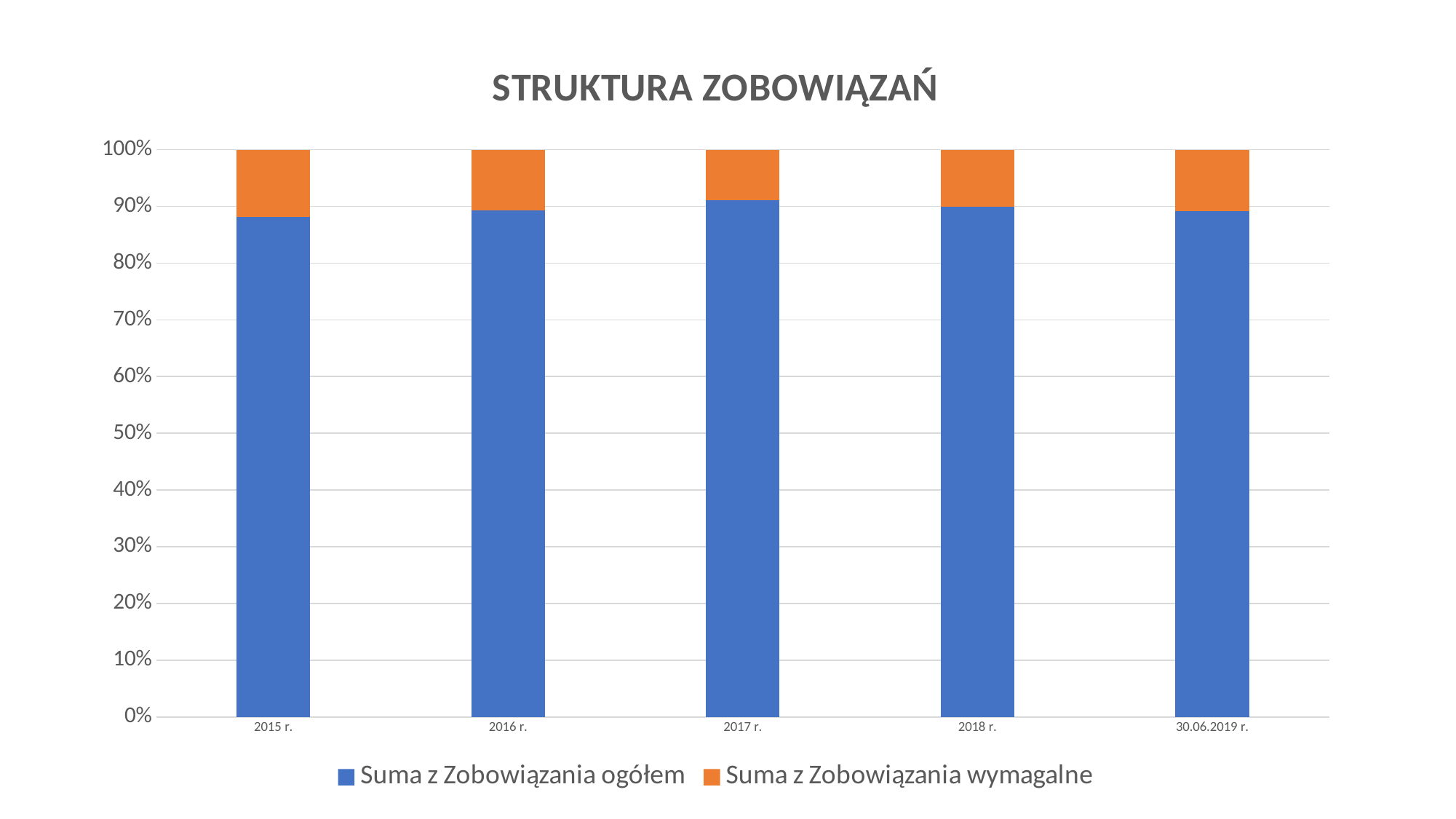
How many categories are shown on the x axis? 5 Is the value of Suma z Zobowiązania wymagalne for 2015 r. greater or less than 20%? less What is the label of the last category on the x axis? 30.06.2019 r. Is the value of Suma z Zobowiązania ogółem for 2015 r. greater or less than 80%? greater Which series is shown in orange in the legend? Suma z Zobowiązania wymagalne What is the title of the chart? STRUKTURA ZOBOWIĄZAŃ What is the total height of the stacked bar for 2016 r.? 100% How many series does the legend list? 2 For 30.06.2019 r., which is larger: Suma z Zobowiązania ogółem or Suma z Zobowiązania wymagalne? Suma z Zobowiązania ogółem Is the value of Suma z Zobowiązania ogółem for 2017 r. greater or less than 50%? greater What kind of chart is shown on the slide? bar chart